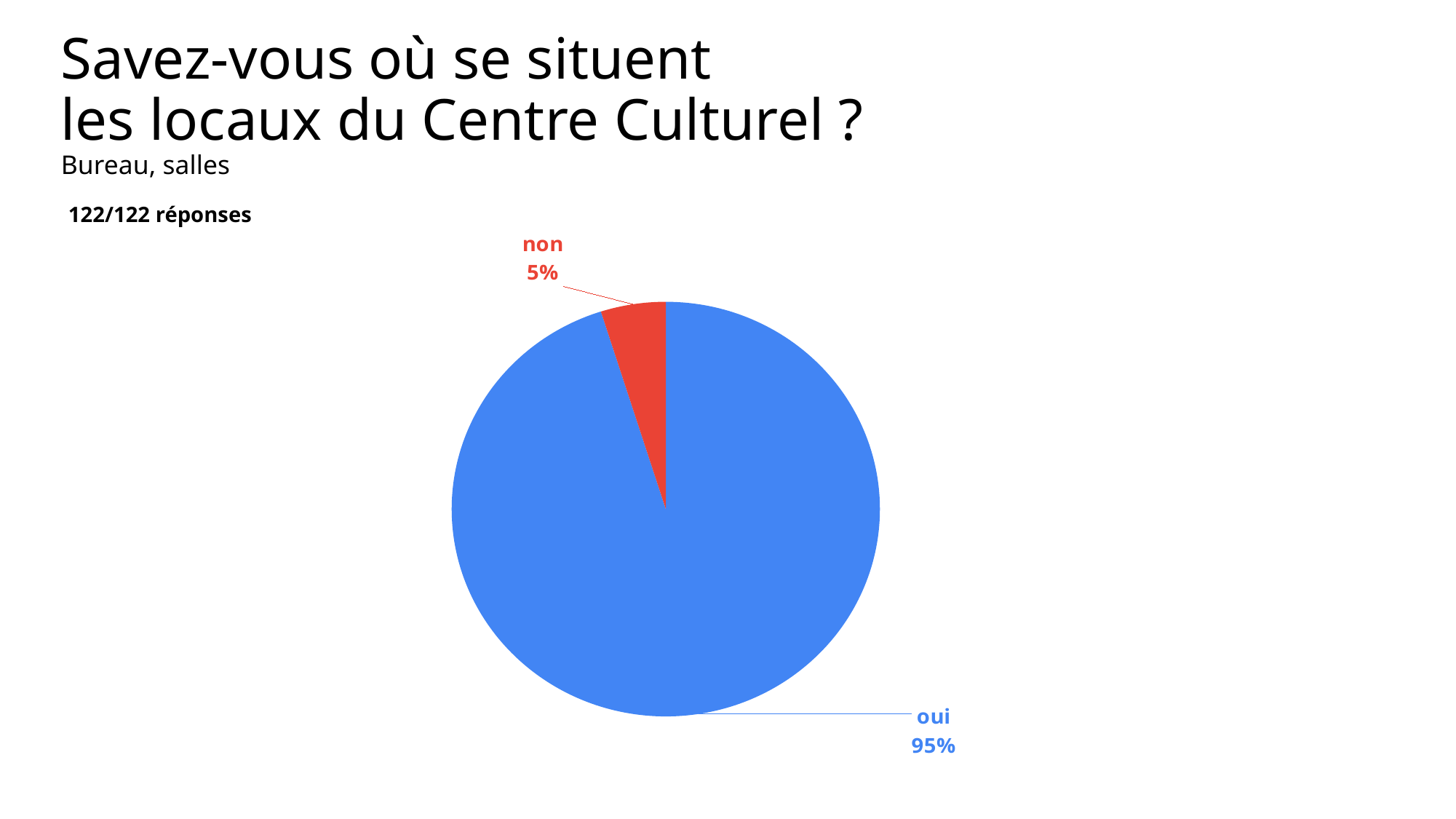
What is the difference in percentage points between the "oui" and "non" slices? 90 What colour is the "non" slice? red What share of the pie does the "non" slice represent? 5% Which slice of the pie is the largest? oui How many slices does the pie chart have? 2 How many responses does the slide say the chart is based on? 122/122 réponses Which is larger, the "oui" slice or the "non" slice? oui What kind of chart is shown on the slide? pie chart What share of the pie does the "oui" slice represent? 95% Which slice of the pie is the smallest? non